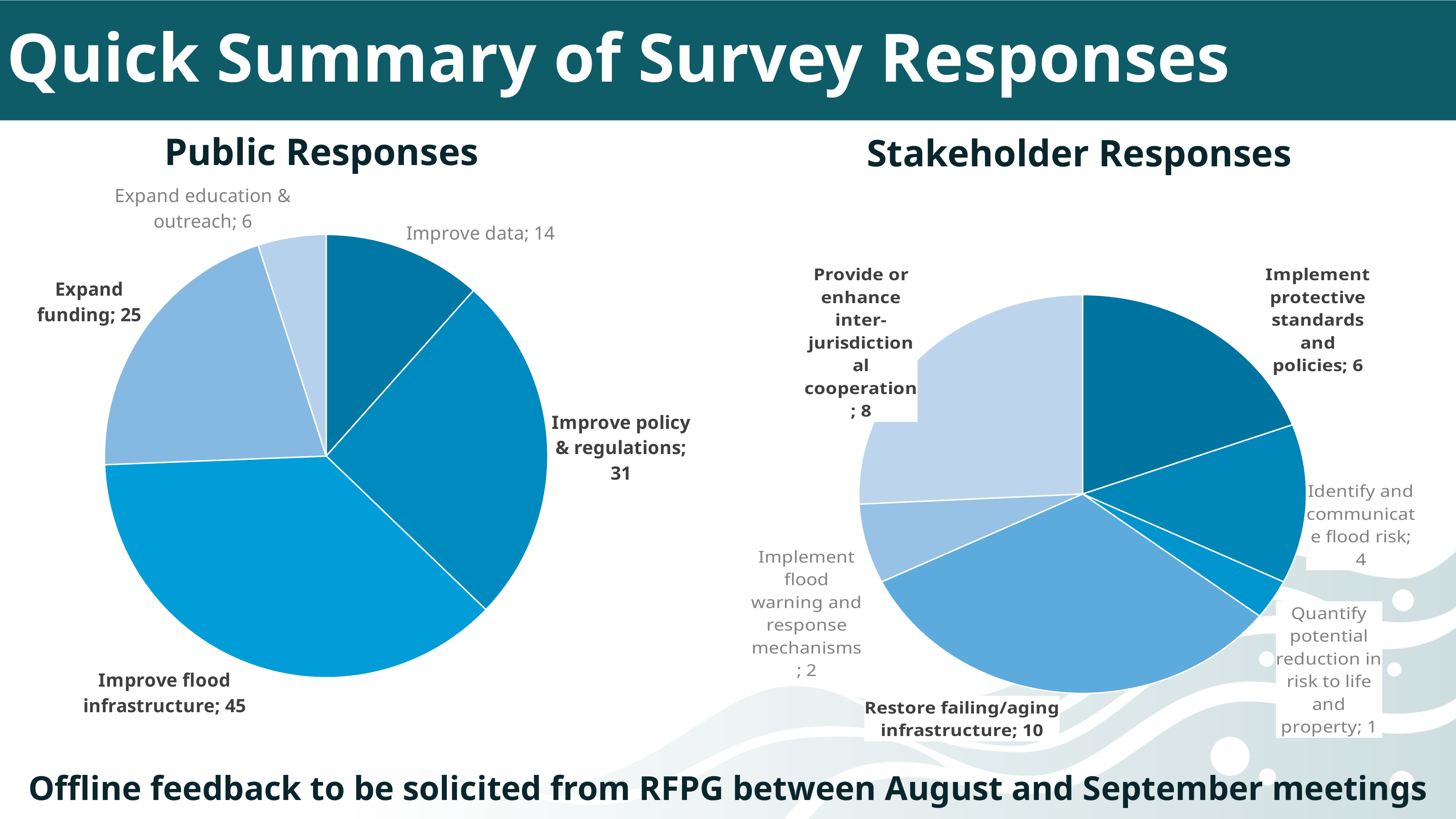
What is the total of all responses in the Stakeholder Responses chart? 31 In the Stakeholder Responses chart, how many responses are for Identify and communicate flood risk? 4 In the Public Responses chart, how many responses are for Expand funding? 25 What type of chart is the Public Responses chart? Pie chart In the Public Responses chart, which category has the largest slice? Improve flood infrastructure In the Public Responses chart, what is the difference between Improve policy & regulations and Improve data? 17 How many categories are shown in the Stakeholder Responses chart? 6 In the Stakeholder Responses chart, which is larger: Provide or enhance inter-jurisdictional cooperation or Implement protective standards and policies? Provide or enhance inter-jurisdictional cooperation In the Stakeholder Responses chart, how many responses are for Restore failing/aging infrastructure? 10 How many categories are shown in the Public Responses chart? 5 In the Stakeholder Responses chart, which category has the smallest slice? Quantify potential reduction in risk to life and property In the Public Responses chart, how many responses are for Improve flood infrastructure? 45